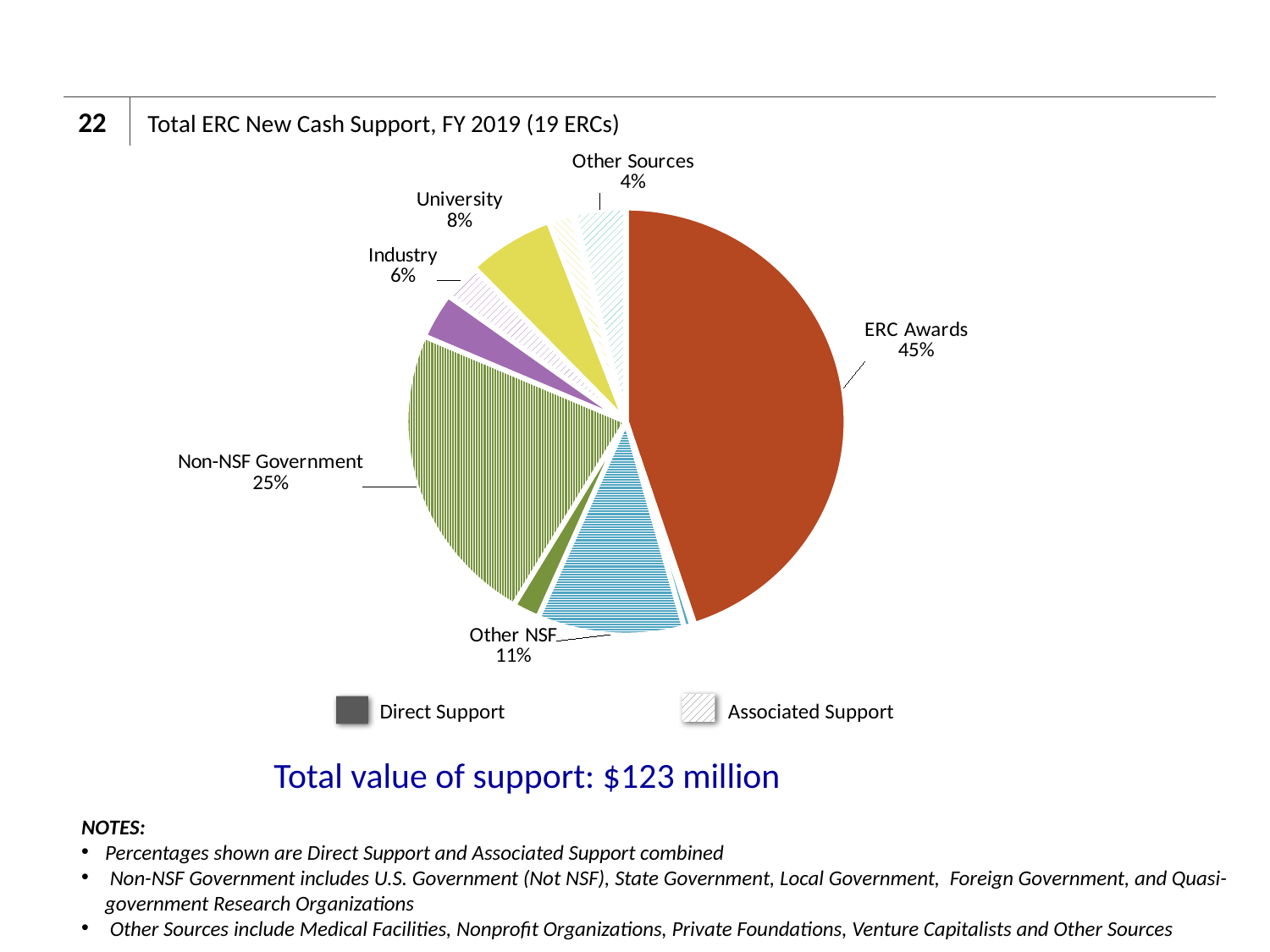
What percentage is shown for University? 8% How many labeled source categories are shown on the pie chart? 6 Which is larger, the University share or the Industry share? University Which labeled source has the smallest share of the pie? Other Sources How many percentage points larger is the ERC Awards share than the Non-NSF Government share? 20 What two support types does the legend list? Direct Support and Associated Support Which labeled source has the largest share of the pie? ERC Awards What percentage of total ERC new cash support comes from ERC Awards? 45% What percentage is shown for Industry? 6% What kind of chart is shown on the slide? Pie chart What share of the pie is labeled Non-NSF Government? 25% What percentage is shown for Other NSF? 11%